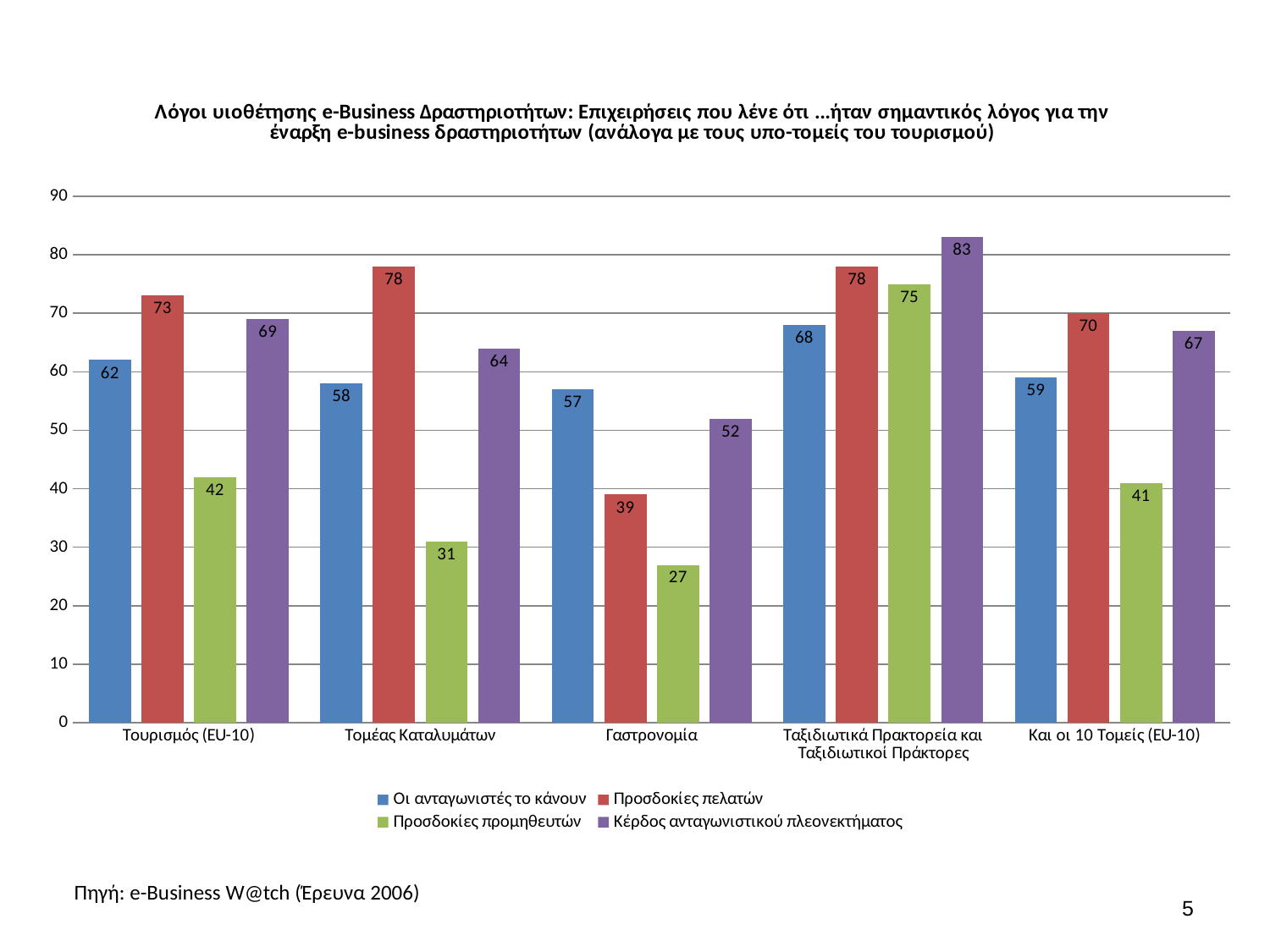
What colour are the bars for Προσδοκίες προμηθευτών? Green What is the value for Κέρδος ανταγωνιστικού πλεονεκτήματος in the Τουρισμός (EU-10) category? 69 Which is larger in the Γαστρονομία category: Οι ανταγωνιστές το κάνουν or Προσδοκίες πελατών? Οι ανταγωνιστές το κάνουν Is the value for Προσδοκίες προμηθευτών in the Και οι 10 Τομείς (EU-10) category greater or less than 50? less What is the value for Προσδοκίες πελατών in the Τομέας Καταλυμάτων category? 78 What is the difference between the Προσδοκίες προμηθευτών values for Ταξιδιωτικά Πρακτορεία και Ταξιδιωτικοί Πράκτορες and Τομέας Καταλυμάτων? 44 Which category has the lowest value for Προσδοκίες πελατών? Γαστρονομία What kind of chart is shown on the slide? Bar chart How many categories are shown on the x axis? 5 How many series does the legend list? 4 Which category has the highest value for Κέρδος ανταγωνιστικού πλεονεκτήματος? Ταξιδιωτικά Πρακτορεία και Ταξιδιωτικοί Πράκτορες What is the value for Προσδοκίες προμηθευτών in the Γαστρονομία category? 27